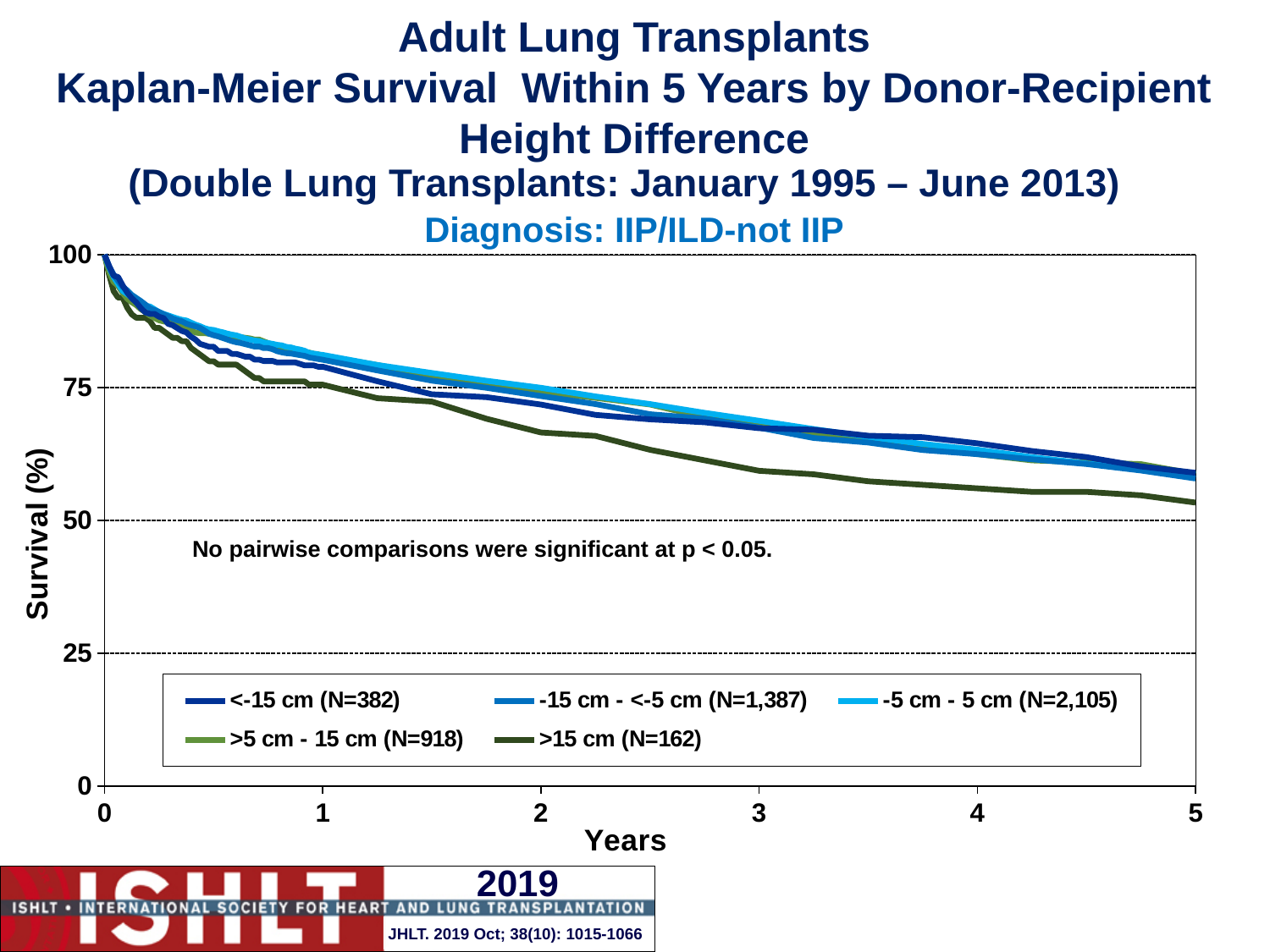
At 2 years, which group has higher survival: >15 cm or -15 cm - <-5 cm? -15 cm - <-5 cm Is the survival for the <-15 cm group at 5 years greater or less than 75? less What is the label of the y axis? Survival (%) Is the survival for the >15 cm group at 5 years greater or less than 75? less Is the survival for the >15 cm group at 3 years greater or less than 50? greater At 5 years, which group has higher survival: >15 cm or -5 cm - 5 cm? -5 cm - 5 cm What kind of chart is shown on the slide? line chart Which height-difference group has the lowest survival at 5 years? >15 cm (N=162) Do the survival curves rise or fall as years increase? fall What is the N for the -5 cm - 5 cm group shown in the legend? 2,105 How many series does the legend list? 5